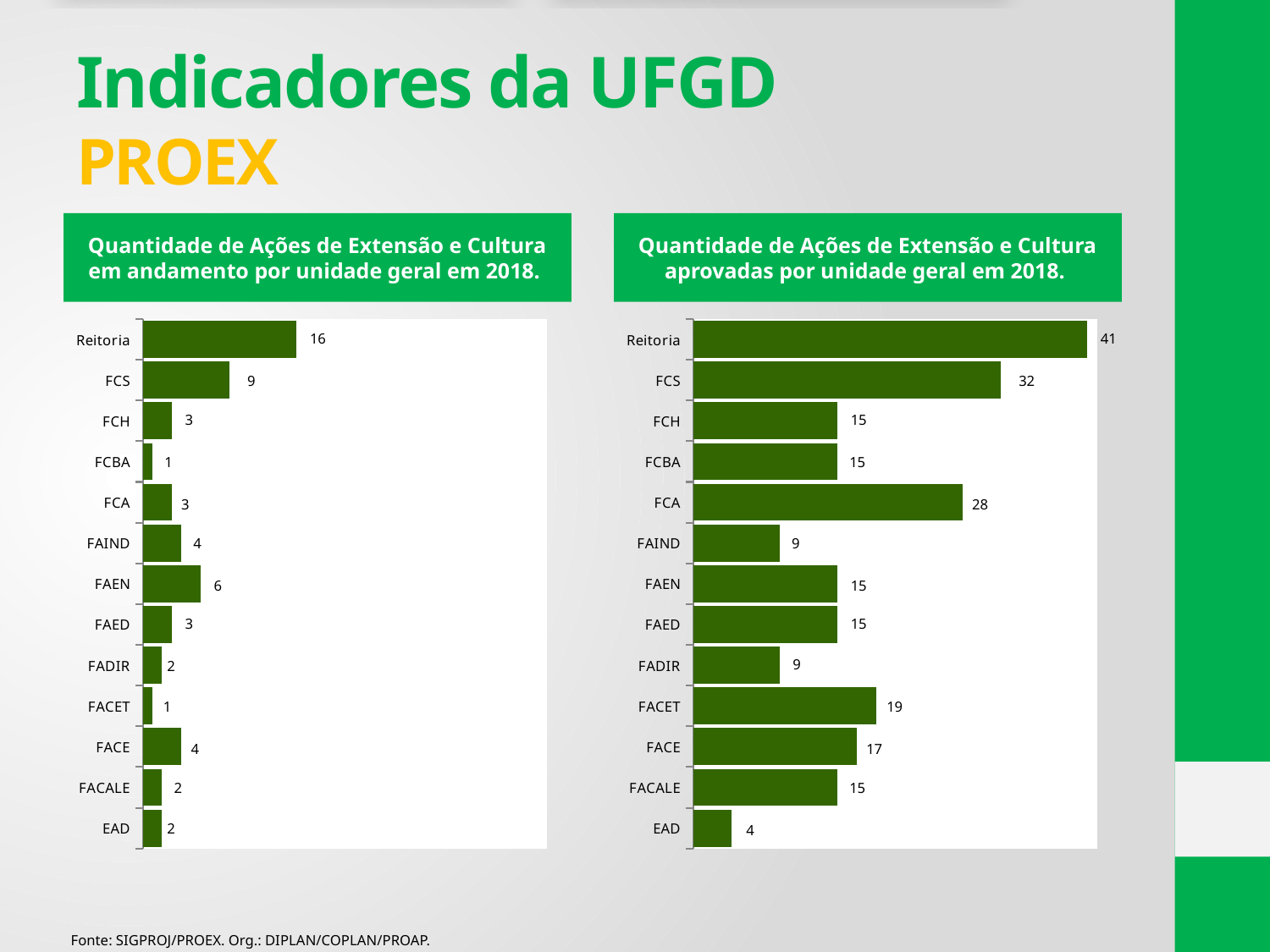
In the right chart (ações aprovadas), which unit has the highest value? Reitoria In the left chart (ações em andamento), which unit has the highest value? Reitoria What type of chart is the right chart (ações aprovadas)? Bar chart In the left chart (ações em andamento), which is larger, FAEN or FAIND? FAEN In the left chart (ações em andamento), what is the value for FACET? 1 In the right chart (ações aprovadas), what is the difference between Reitoria and FCS? 9 In the left chart (ações em andamento), what is the difference between Reitoria and FCS? 7 In the right chart (ações aprovadas), what is the value for FCA? 28 In the left chart (ações em andamento), what is the value for Reitoria? 16 How many units are shown in the left chart (ações em andamento)? 13 In the right chart (ações aprovadas), which unit has the lowest value? EAD In the right chart (ações aprovadas), which is larger, FACET or FACE? FACET